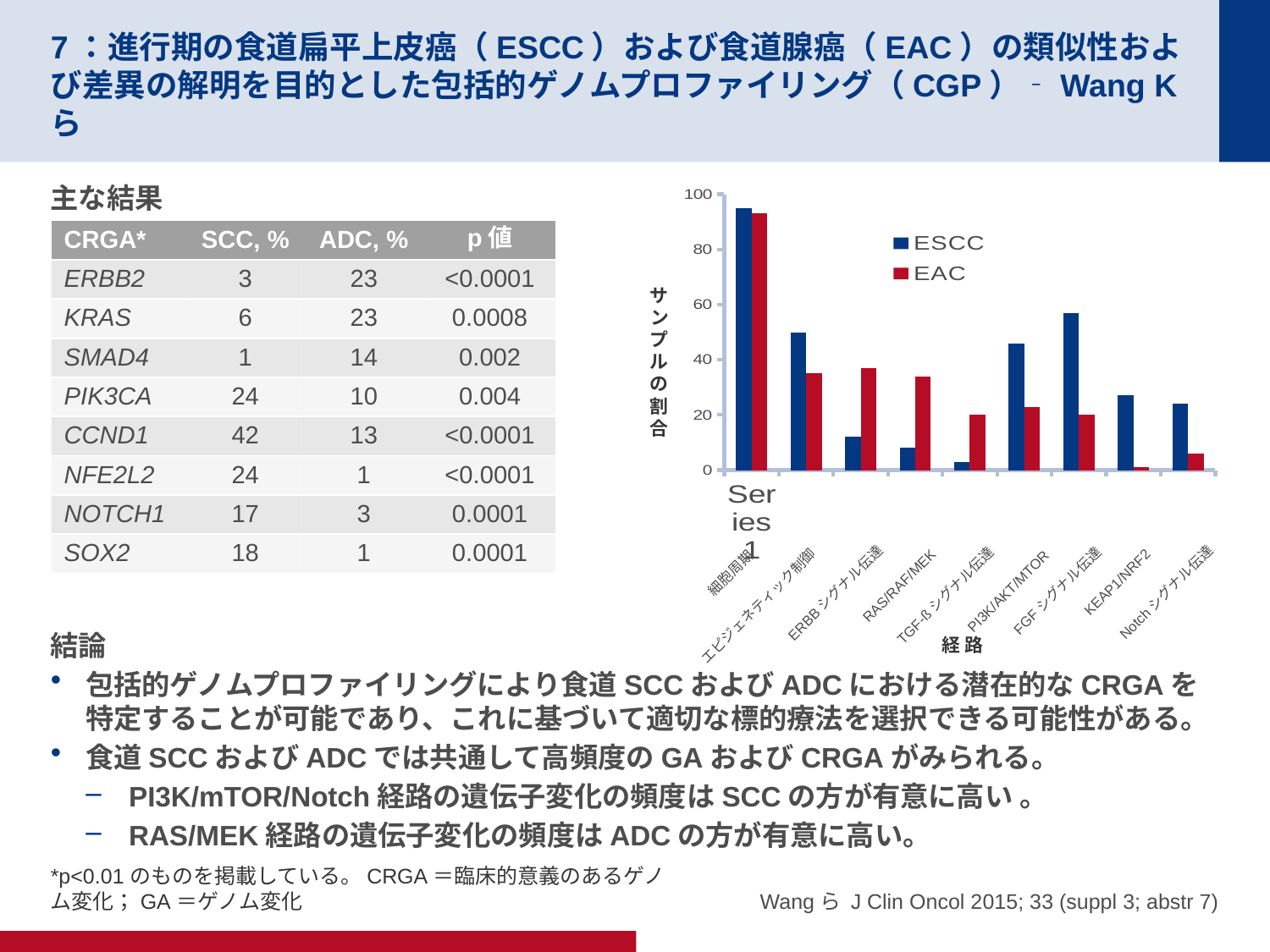
Which pathway has the lowest EAC value in the chart? KEAP1/NRF2 For ERBB シグナル伝達, which series has the larger value, ESCC or EAC? EAC What is the label of the vertical axis of the chart? サンプルの割合 Which pathway has the highest ESCC value in the chart? 細胞周期 Is the EAC value for RAS/RAF/MEK greater or less than 20? greater Which two series are listed in the chart legend? ESCC and EAC Is the ESCC value for TGF-ß シグナル伝達 greater or less than 20? less Is the ESCC value for 細胞周期 greater or less than 80? greater For FGF シグナル伝達, which series has the larger value, ESCC or EAC? ESCC What kind of chart is shown on the slide? Bar chart How many pathway categories are plotted along the x axis of the chart? 9 How many series does the chart legend list? 2